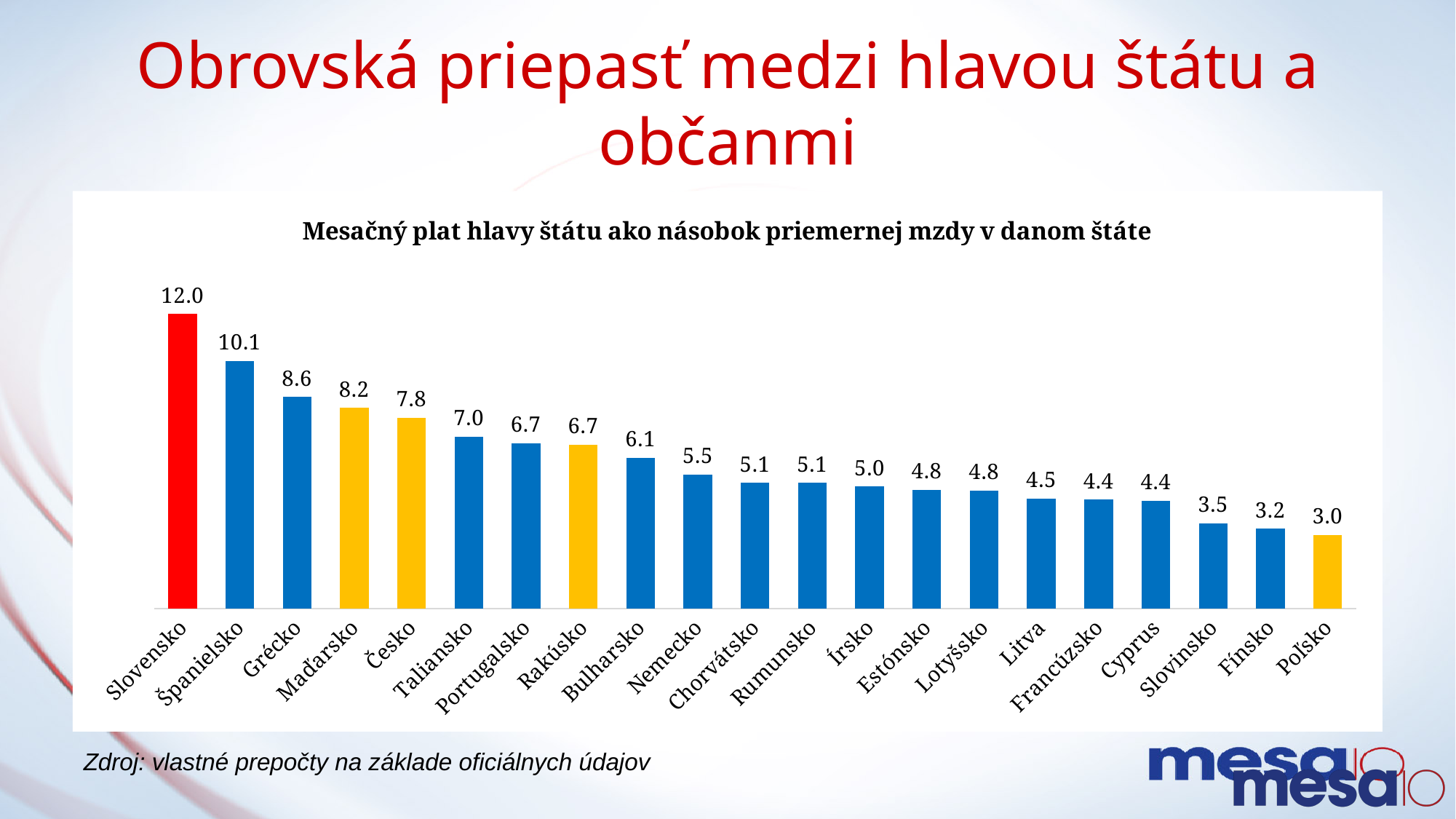
What is the difference between the values for Slovensko and Španielsko? 1.9 Which is larger, the value for Taliansko or the value for Bulharsko? Taliansko Which country has the lowest value? Poľsko What kind of chart is shown on the slide? Bar chart What is the value for Slovensko? 12.0 Which country has the highest value? Slovensko How many countries are shown in the chart? 21 What is the value for Česko? 7.8 What is the difference between the values for Grécko and Maďarsko? 0.4 What is the value for Nemecko? 5.5 What colour is the bar for Slovensko? Red Do the values rise or fall from left to right along the x axis? Fall